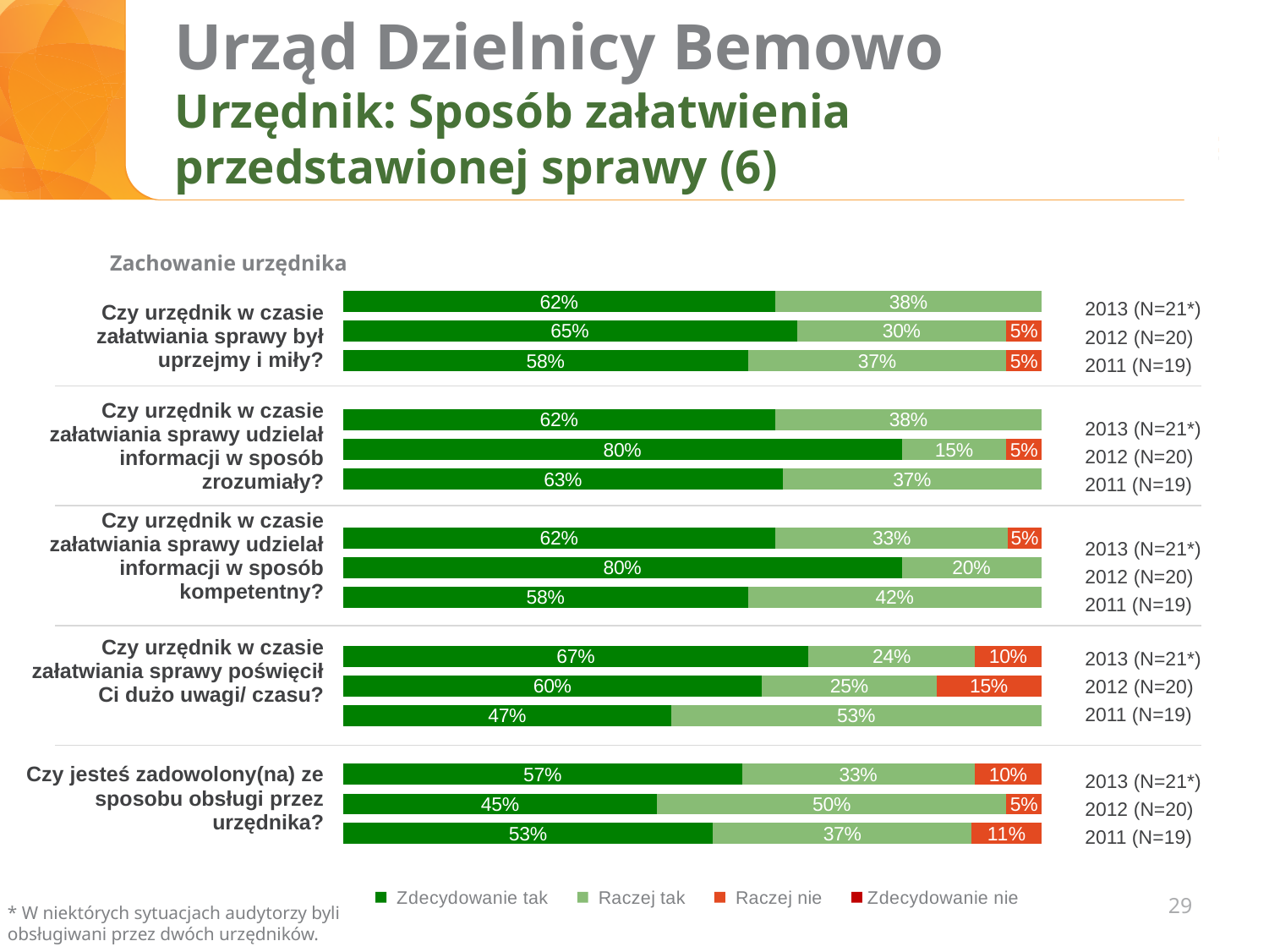
For the question "Czy urzędnik w czasie załatwiania sprawy poświęcił Ci dużo uwagi/ czasu?", does the "Zdecydowanie tak" share rise or fall from 2011 to 2013? Rise For the question "Czy jesteś zadowolony(na) ze sposobu obsługi przez urzędnika?", which year has the larger "Zdecydowanie tak" share: 2013 or 2012? 2013 (N=21*) How many series does the legend list? 4 How many survey questions are shown in the chart? 5 What is the "Zdecydowanie tak" value for 2011 (N=19) for the question "Czy urzędnik w czasie załatwiania sprawy poświęcił Ci dużo uwagi/ czasu?"? 47% For the question "Czy urzędnik w czasie załatwiania sprawy udzielał informacji w sposób zrozumiały?", which year has the highest "Zdecydowanie tak" share? 2012 (N=20) What percentage answered "Zdecydowanie tak" in 2013 to the question "Czy urzędnik w czasie załatwiania sprawy był uprzejmy i miły?"? 62% For the question "Czy urzędnik w czasie załatwiania sprawy był uprzejmy i miły?" in 2012, what is the combined share of "Zdecydowanie tak" and "Raczej tak"? 95% For the question "Czy urzędnik w czasie załatwiania sprawy poświęcił Ci dużo uwagi/ czasu?", which year has the lowest "Zdecydowanie tak" share? 2011 (N=19) What kind of chart is shown on the slide? Stacked bar chart What is the "Raczej tak" value for 2012 (N=20) for the question "Czy jesteś zadowolony(na) ze sposobu obsługi przez urzędnika?"? 50% For the question about giving information "w sposób kompetentny", how many percentage points higher is the "Zdecydowanie tak" share in 2012 than in 2011? 22 percentage points